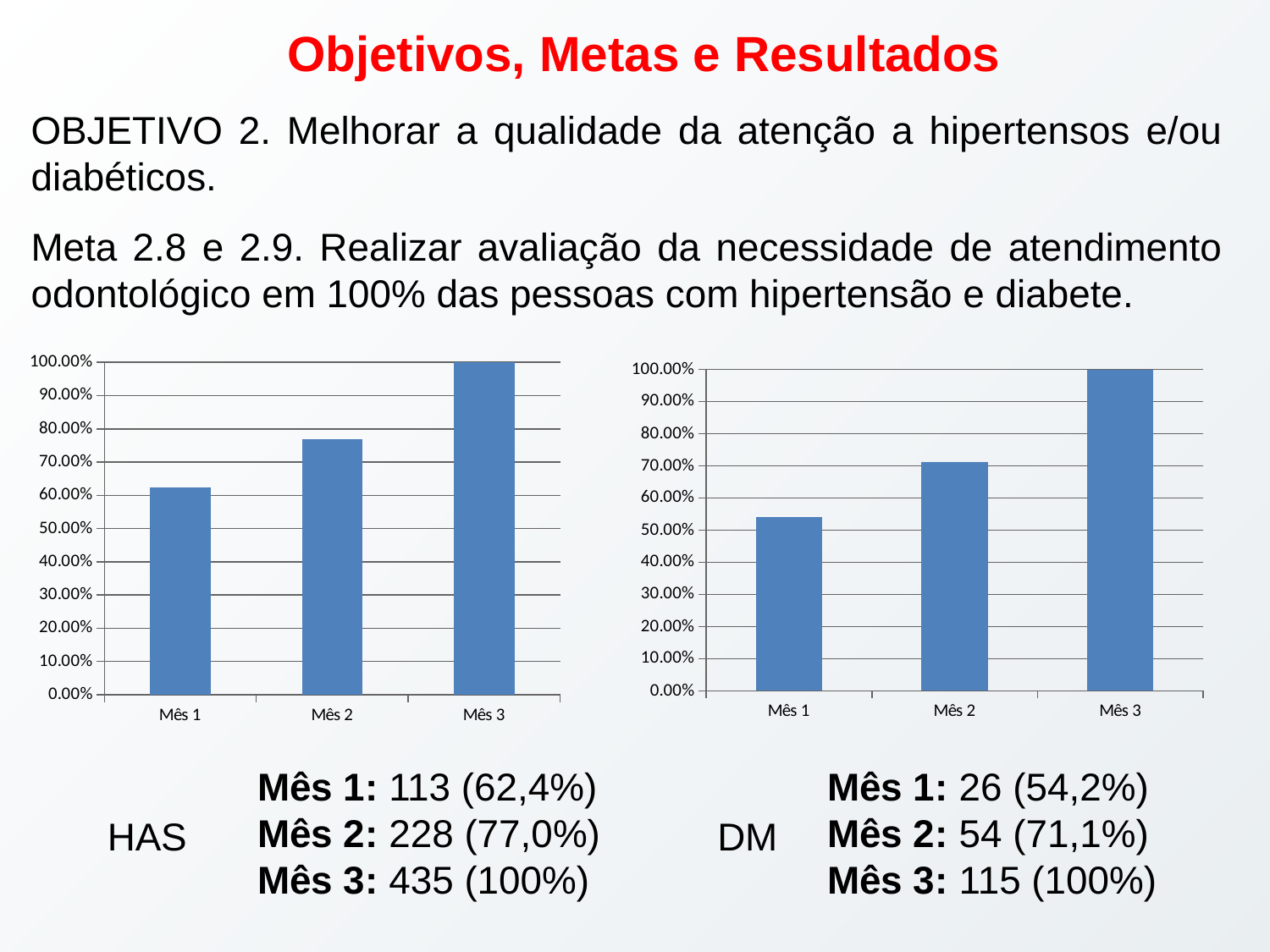
How many categories does the right chart (DM) show on its x axis? 3 What kind of chart is the left chart (HAS)? bar chart In the right chart (DM), what is the value for Mês 3? 100.00% In the right chart (DM), is the value for Mês 2 greater or less than 80.00%? less In the right chart (DM), which month has the lowest value? Mês 1 According to the text below the left chart, what percentage is given for HAS in Mês 2? 77,0% In the left chart (HAS), which month has the highest value? Mês 3 In the left chart (HAS), is the value for Mês 1 greater or less than 60.00%? greater In the left chart (HAS), which is larger, the value for Mês 1 or the value for Mês 2? Mês 2 In the left chart (HAS), what is the value for Mês 3? 100.00% Do the values in the right chart (DM) rise or fall from Mês 1 to Mês 3? rise In the right chart (DM), is the value for Mês 1 greater or less than 60.00%? less